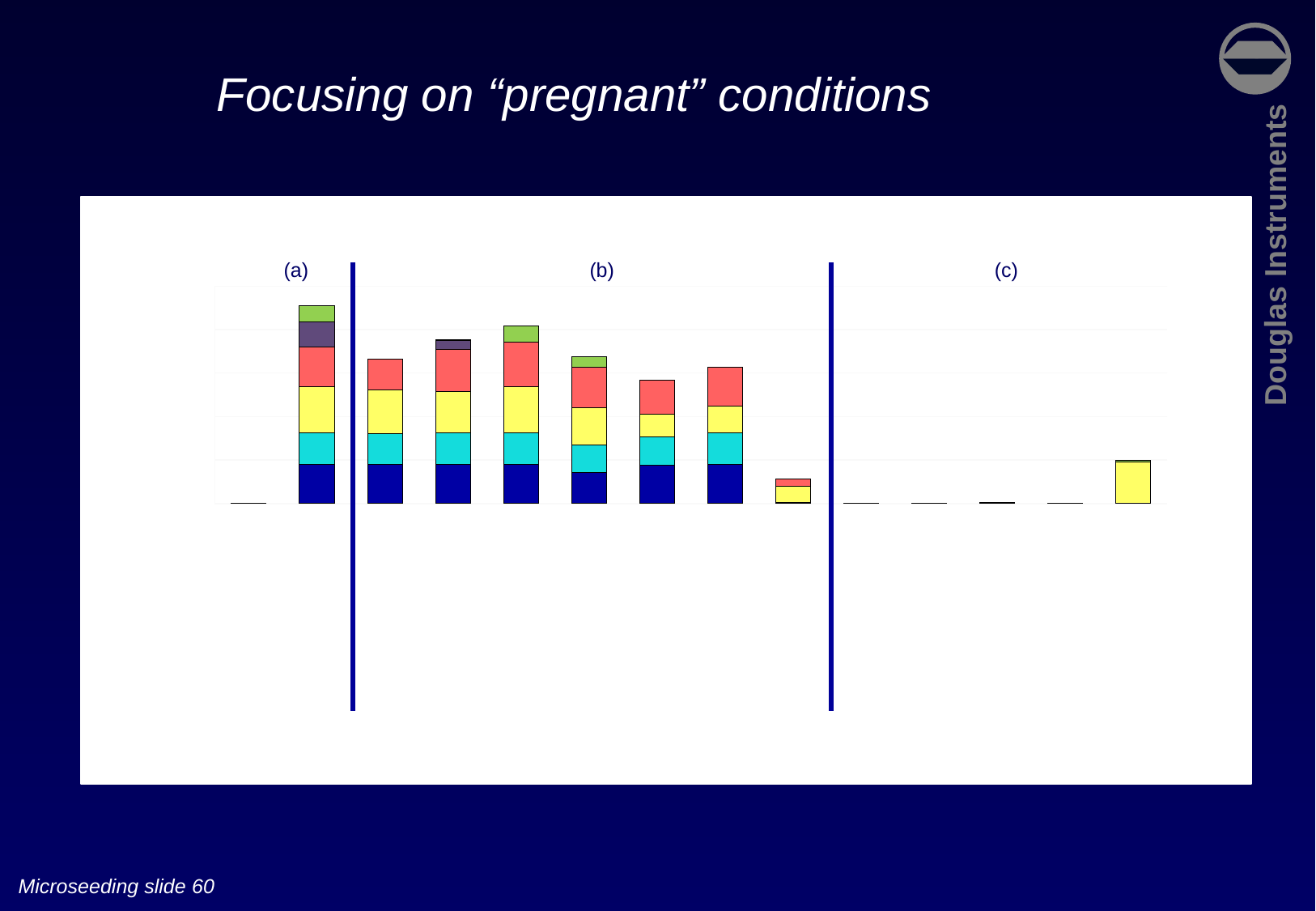
What kind of chart is shown on the slide? Stacked bar chart Is the tallest bar in section (c) taller or shorter than the tallest bar in section (b)? Shorter How many bars are plotted in section (a) of the chart? 2 Which section of the chart contains the most bars? (b) How many bars are plotted in the chart in total? 14 How many bars are plotted in section (c) of the chart? 5 What colour is the bottom segment of the tall stacked bars in sections (a) and (b)? Dark blue Which section of the chart contains the tallest stacked bar? (a) What are the labels of the three sections of the chart? (a), (b), (c)